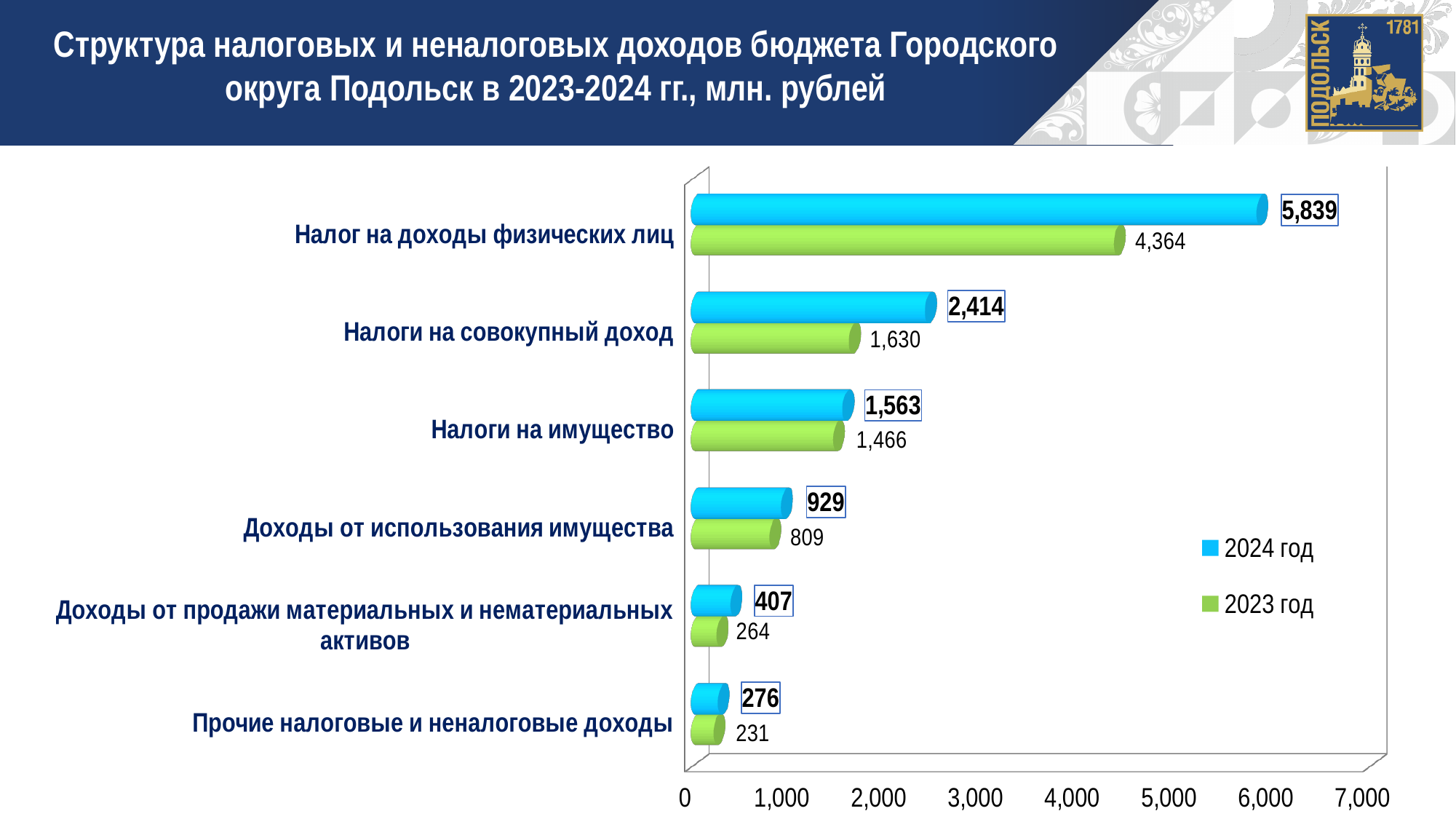
How many categories are shown on the chart? 6 Which category has the highest value in the 2024 год series? Налог на доходы физических лиц What is the difference between the 2024 год and 2023 год values for "Налог на доходы физических лиц"? 1,475 Which is larger for "Налоги на имущество": the 2024 год value or the 2023 год value? 2024 год What kind of chart is shown on the slide? Bar chart Which colour represents the 2023 год series in the chart? Green What is the value for "Доходы от использования имущества" in the 2024 год series? 929 What is the difference between the 2024 год and 2023 год values for "Доходы от продажи материальных и нематериальных активов"? 143 Which category has the lowest value in the 2023 год series? Прочие налоговые и неналоговые доходы What is the value for "Налоги на совокупный доход" in the 2023 год series? 1,630 What is the value for "Налог на доходы физических лиц" in the 2024 год series? 5,839 How many series does the legend list? 2